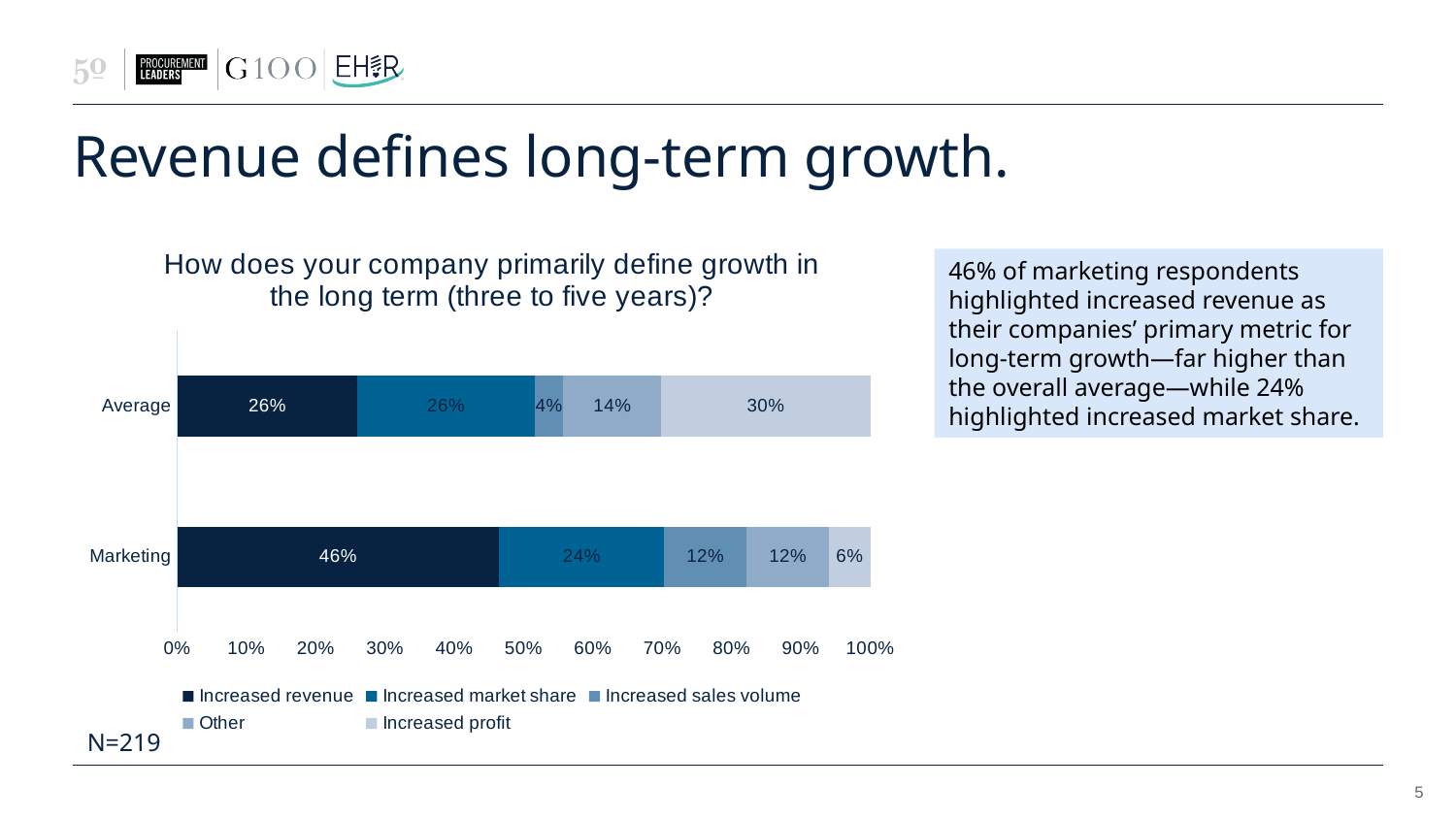
What is the difference between the Increased revenue values for Marketing and Average? 20% What is the value for Increased profit in the Average bar? 30% How many categories are plotted on the chart? 2 What is the value for Increased revenue in the Marketing bar? 46% What kind of chart is shown on the slide? Stacked bar chart What is the chart's title? How does your company primarily define growth in the long term (three to five years)? Which segment is the largest in the Average bar? Increased profit What is the value for Increased sales volume in the Average bar? 4% What is the value for Increased revenue in the Average bar? 26% What is the value for Increased market share in the Marketing bar? 24% Which is larger: Increased profit for Average or Increased profit for Marketing? Average How many series does the legend list? 5